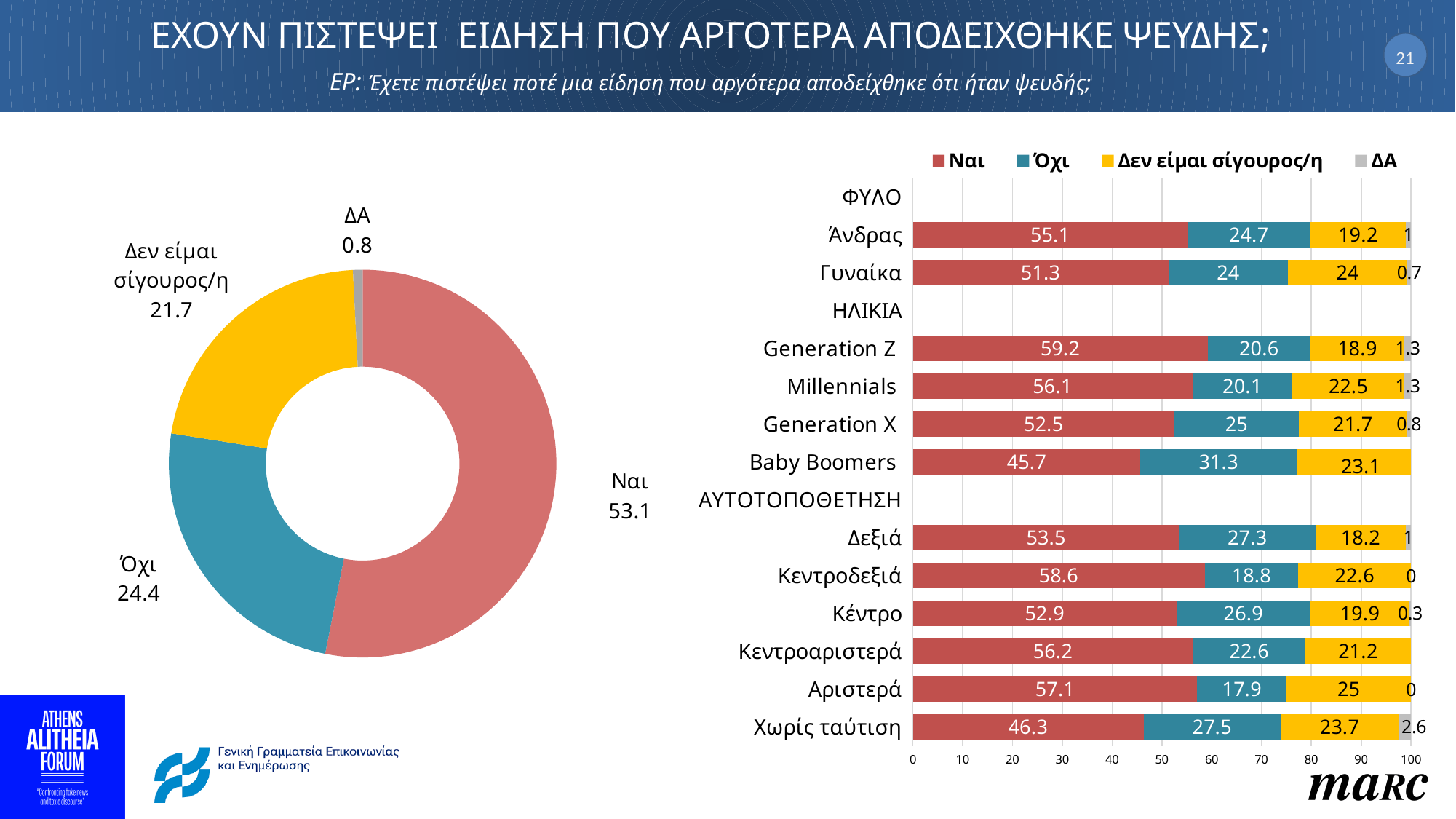
What kind of chart is the chart on the right of the slide? stacked bar chart In the doughnut chart on the left, what is the value for Δεν είμαι σίγουρος/η? 21.7 What kind of chart is the chart on the left of the slide? doughnut chart In the doughnut chart on the left, what is the difference between Όχι and Δεν είμαι σίγουρος/η? 2.7 In the bar chart on the right, which group has the lowest Ναι value? Baby Boomers In the bar chart on the right, what is the Όχι value for Baby Boomers? 31.3 In the bar chart on the right, which is larger: the Ναι value for Άνδρας or for Γυναίκα? Άνδρας How many series does the legend of the bar chart on the right list? 4 In the doughnut chart on the left, what is the value for Ναι? 53.1 In the doughnut chart on the left, which category has the smallest value? ΔΑ In the bar chart on the right, what is the Ναι value for Generation Z? 59.2 In the bar chart on the right, what is the difference between the Ναι values for Κεντροδεξιά and Αριστερά? 1.5